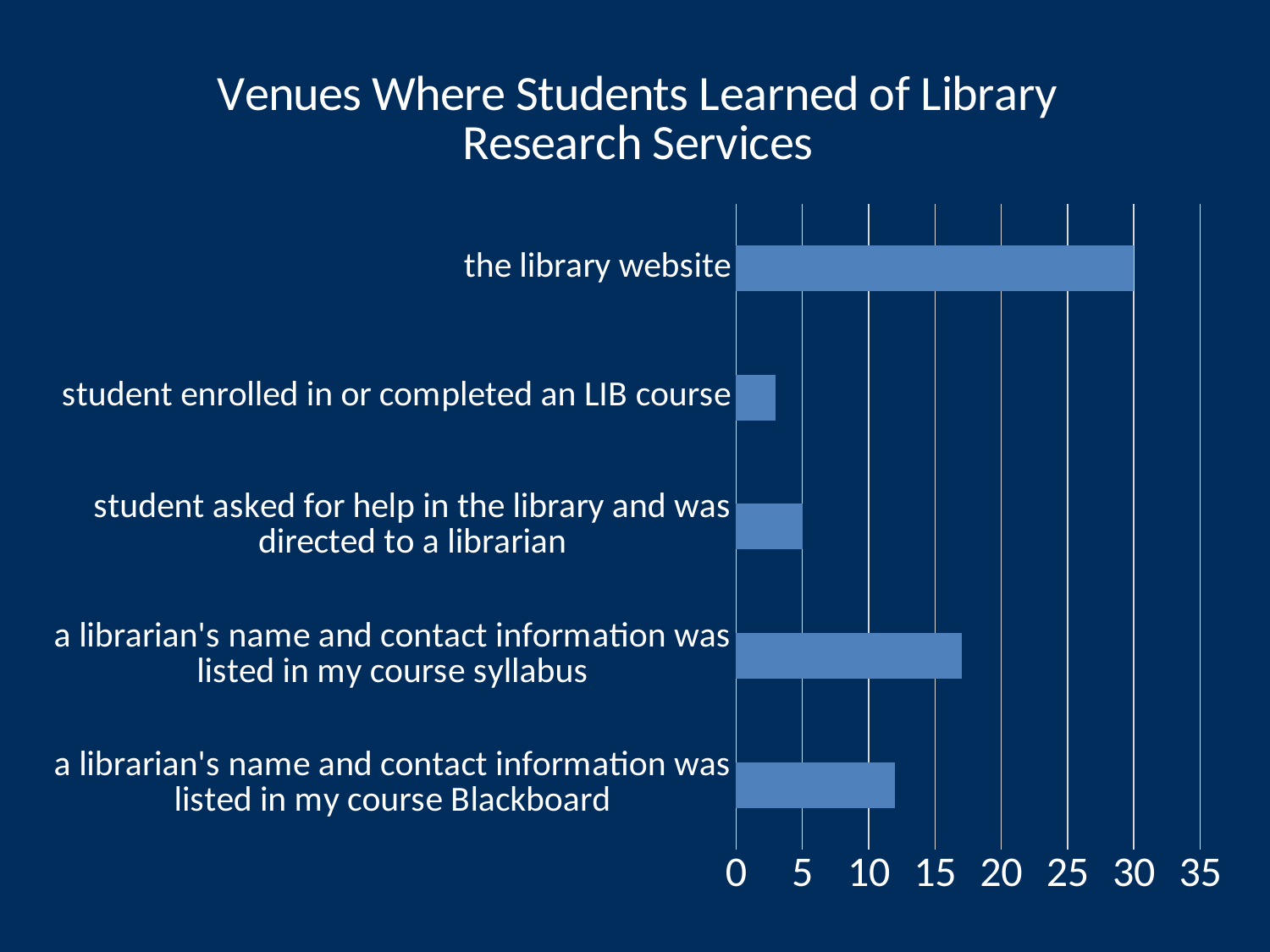
Which is larger: the value for 'a librarian's name and contact information was listed in my course syllabus' or for 'a librarian's name and contact information was listed in my course Blackboard'? a librarian's name and contact information was listed in my course syllabus What kind of chart is shown on the slide? bar chart Is the value for 'student enrolled in or completed an LIB course' greater or less than 5? less Which is larger: the value for 'student asked for help in the library and was directed to a librarian' or for 'student enrolled in or completed an LIB course'? student asked for help in the library and was directed to a librarian How many categories (venues) are plotted in the chart? 5 Is the value for 'the library website' greater or less than 25? greater Is the value for 'a librarian's name and contact information was listed in my course syllabus' greater or less than 15? greater Which venue has the highest value in the chart? the library website What is the value for 'the library website'? 30 What is the title of the chart? Venues Where Students Learned of Library Research Services Which venue has the lowest value in the chart? student enrolled in or completed an LIB course